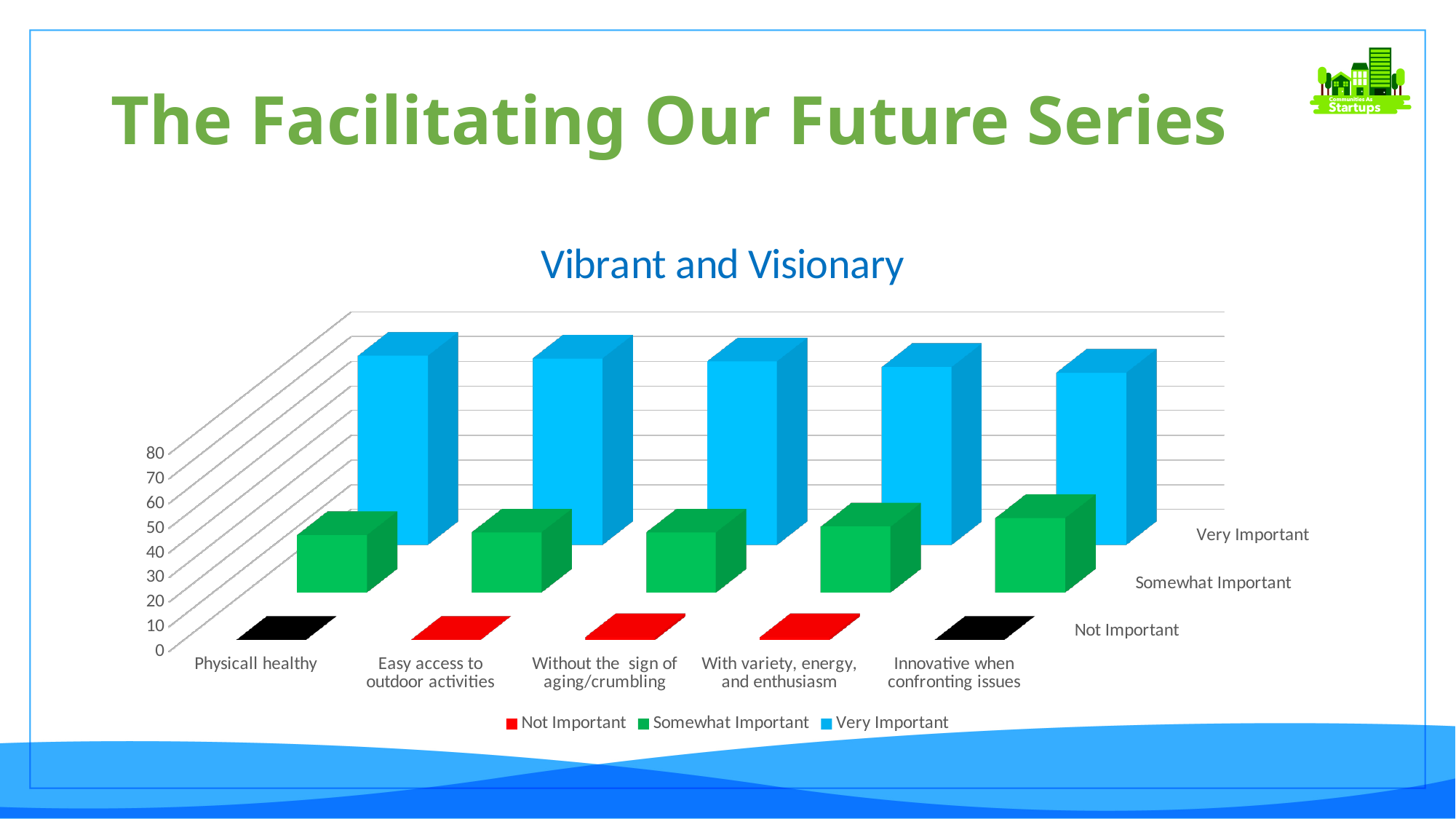
Do the Very Important values rise or fall from left to right across the categories? fall What is the title of the chart? Vibrant and Visionary How many series does the chart legend list? 3 How many categories are shown along the x axis of the chart? 5 Which series is shown in blue in the chart? Very Important Which category has the highest Very Important value? Physicall healthy Is the Very Important value for Physicall healthy greater or less than 50? greater What kind of chart is shown on the slide? bar chart Is the Not Important value for Without the sign of aging/crumbling greater or less than 10? less For With variety, energy, and enthusiasm, which is larger: Very Important or Somewhat Important? Very Important Is the Somewhat Important value for Easy access to outdoor activities greater or less than 40? less Which category has the lowest Very Important value? Innovative when confronting issues